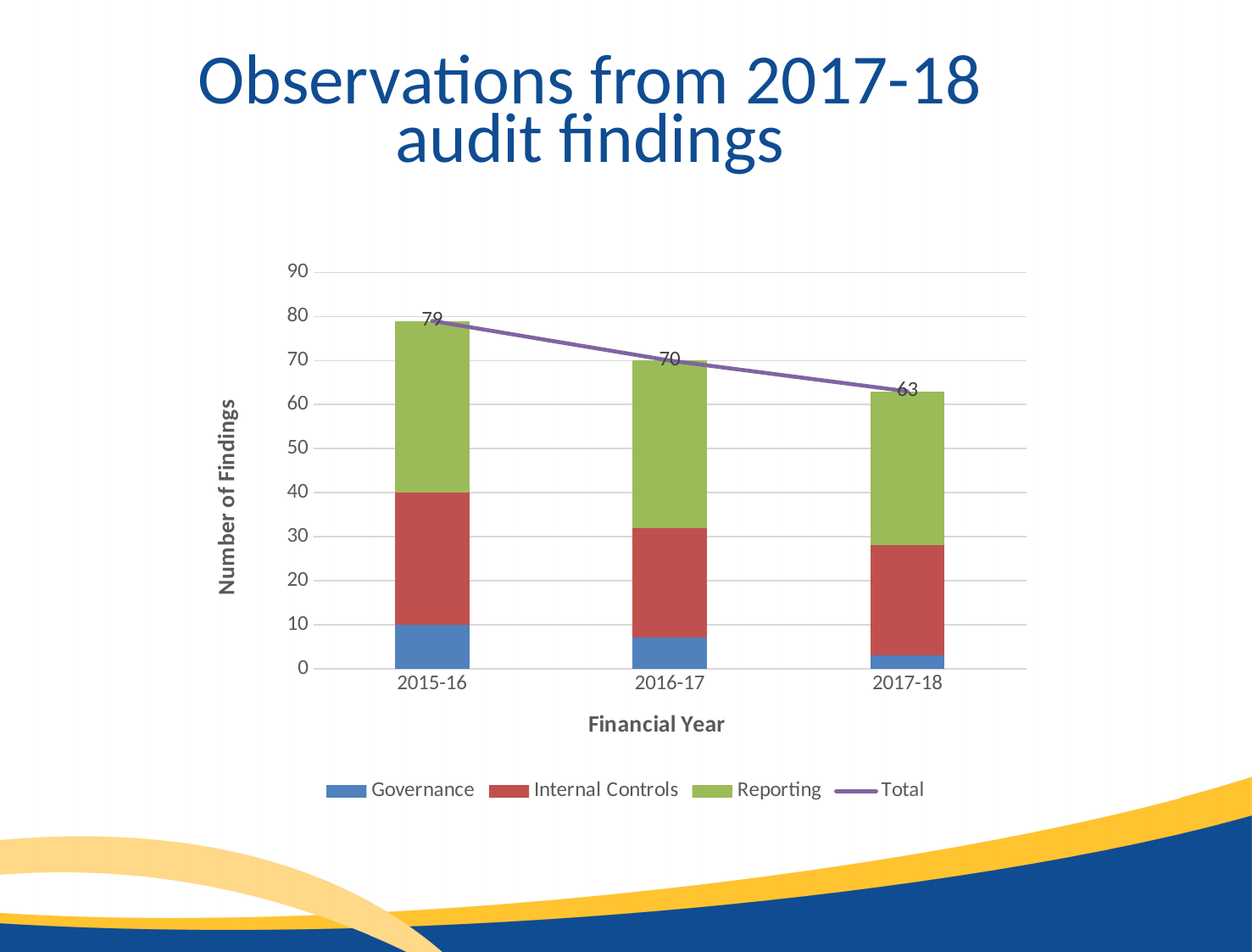
What is the difference between the Total for 2015-16 and the Total for 2017-18? 16 Does the Total number of findings rise or fall from 2015-16 to 2017-18? fall Which financial year has the highest Total number of findings? 2015-16 What is the Total value for 2015-16? 79 Which is larger, the Total for 2016-17 or the Total for 2017-18? 2016-17 How many financial years are shown on the x axis? 3 What is the Total value for 2017-18? 63 Which financial year has the lowest Total number of findings? 2017-18 Is the Governance value for 2017-18 greater or less than 10? less What kind of chart is shown on the slide? combination stacked bar and line chart What is the Total value for 2016-17? 70 How many series does the legend list? 4